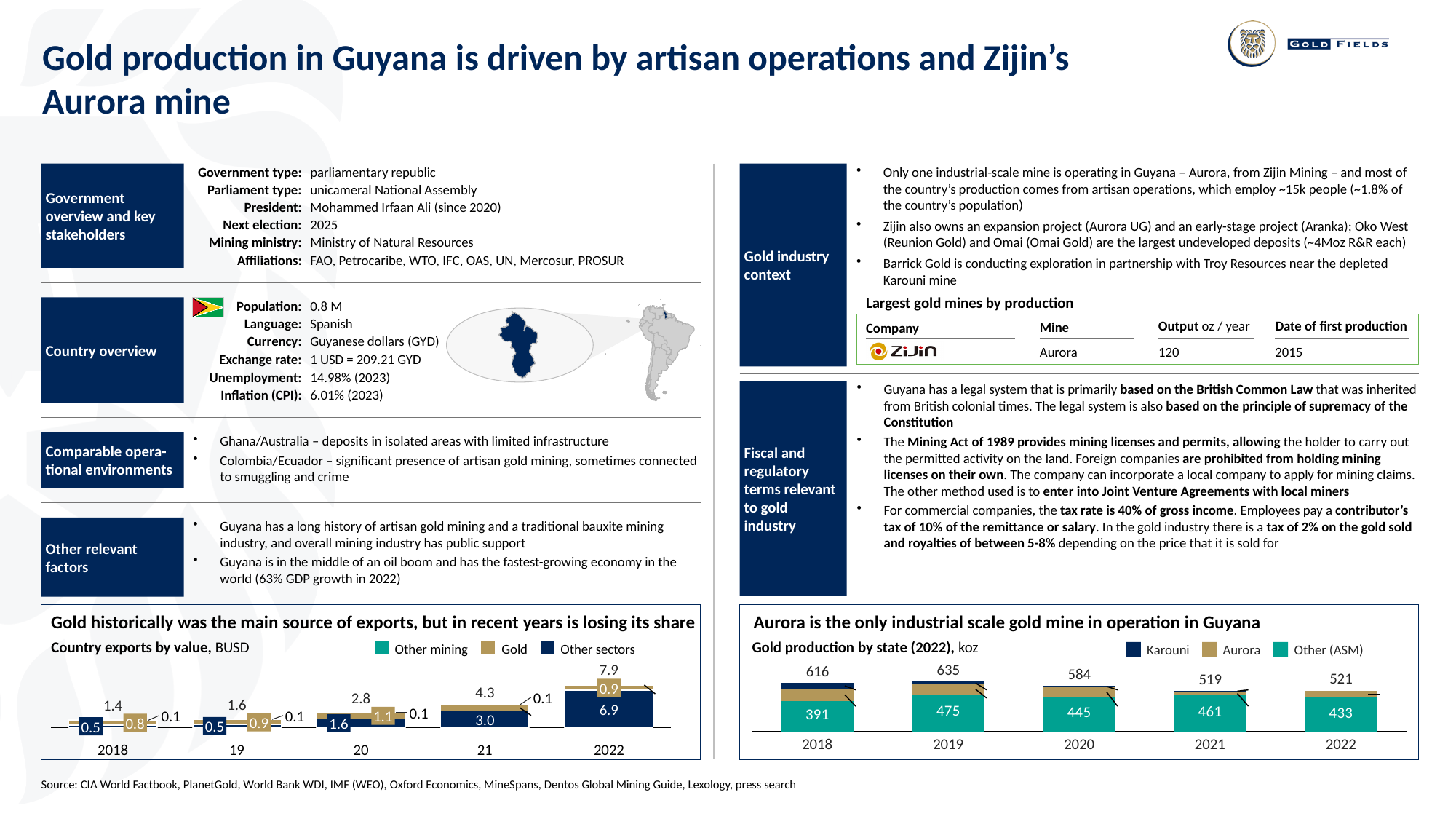
In the 'Country exports by value' chart, which year had the highest total exports? 2022 In the 'Country exports by value' chart, what was the total export value in 2022? 7.9 In the 'Country exports by value' chart, how many series does the legend list? 3 In the 'Gold production by state (2022)' chart, what was the total gold production in 2020? 584 What kind of chart is the 'Gold production by state (2022)' chart? stacked bar chart In the 'Country exports by value' chart, do total exports rise or fall from 2018 to 2022? rise In the 'Gold production by state (2022)' chart, which is larger: Other (ASM) production in 2019 or in 2018? 2019 In the 'Gold production by state (2022)' chart, what was the Other (ASM) production in 2019? 475 In the 'Country exports by value' chart, what is the difference between the total exports in 2022 and 2021? 3.6 In the 'Gold production by state (2022)' chart, which year had the lowest total gold production? 2021 In the 'Country exports by value' chart, what was the Gold export value in 2018? 0.8 In the 'Country exports by value' chart, what was the Other sectors value in 2021? 3.0